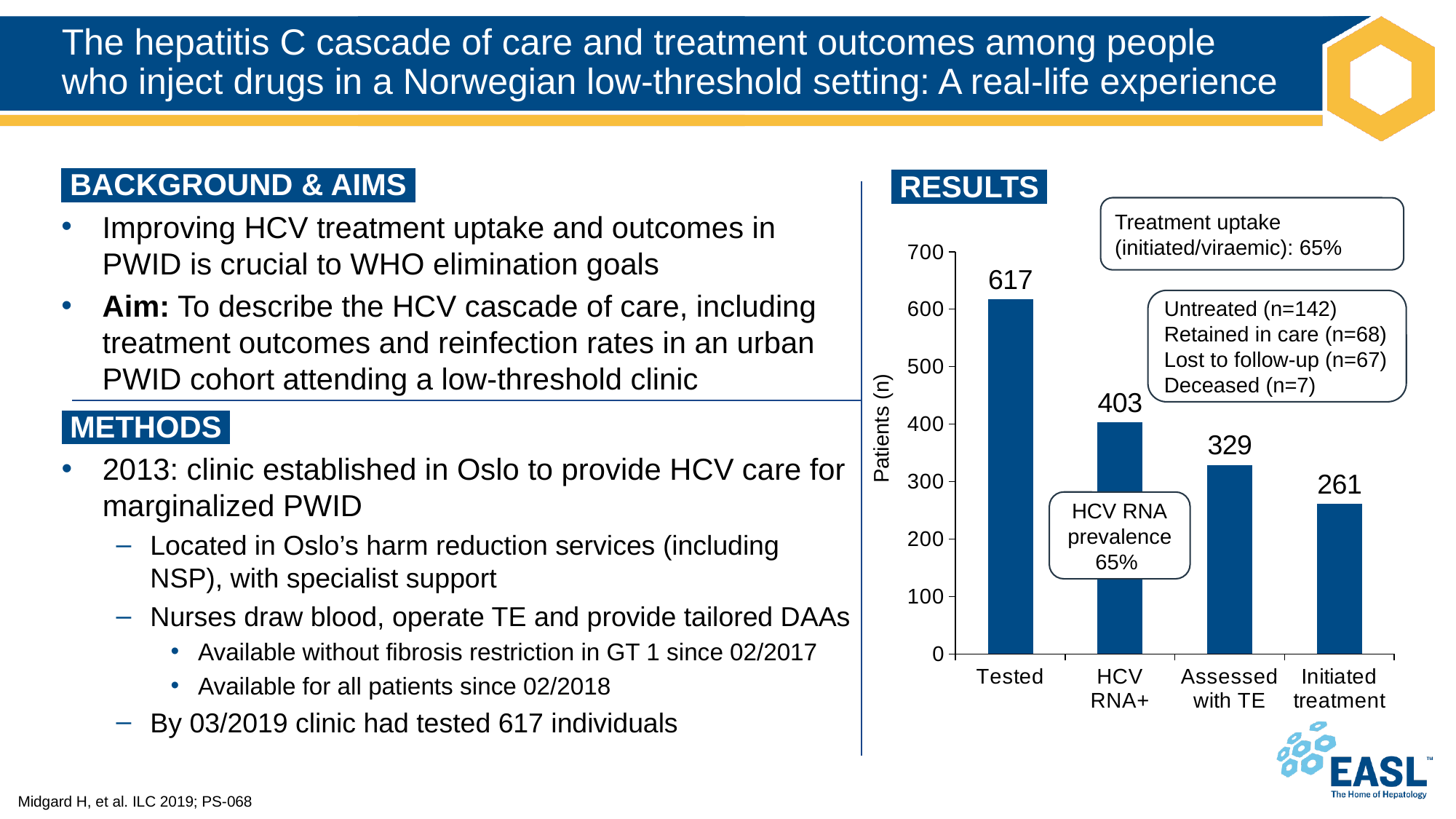
What kind of chart is shown on the slide? Bar chart Which category has the lowest value in the chart? Initiated treatment What is the difference between the number assessed with TE and the number who initiated treatment? 68 Which is larger: the value for HCV RNA+ or the value for Assessed with TE? HCV RNA+ Do the values rise or fall from left to right along the x axis? Fall What is the difference between the number tested and the number HCV RNA+? 214 Which category has the highest value in the chart? Tested How many patients were assessed with TE? 329 How many patients were tested according to the chart? 617 What is the value for HCV RNA+ in the chart? 403 How many categories are shown on the x axis of the chart? 4 How many patients initiated treatment? 261